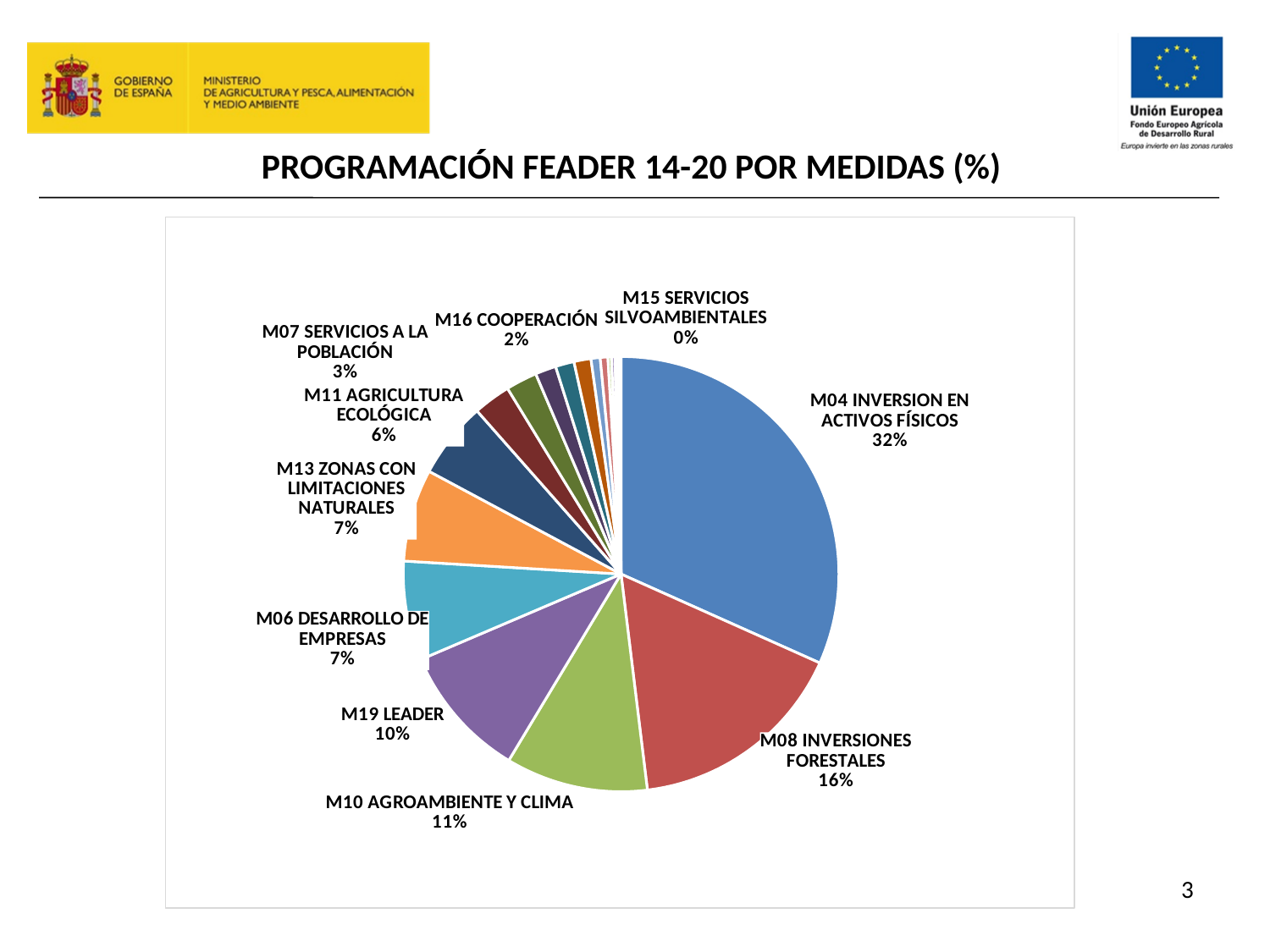
What percentage is shown for M19 LEADER? 10% What percentage is shown for M07 SERVICIOS A LA POBLACIÓN? 3% What percentage is shown for M11 AGRICULTURA ECOLÓGICA? 6% Which is larger, M10 AGROAMBIENTE Y CLIMA or M19 LEADER? M10 AGROAMBIENTE Y CLIMA What is the title of the chart? PROGRAMACIÓN FEADER 14-20 POR MEDIDAS (%) Which measure has the largest slice of the pie? M04 INVERSION EN ACTIVOS FÍSICOS What is the difference in percentage points between M04 INVERSION EN ACTIVOS FÍSICOS and M08 INVERSIONES FORESTALES? 16 What percentage is shown for M08 INVERSIONES FORESTALES? 16% What percentage is shown for M10 AGROAMBIENTE Y CLIMA? 11% What percentage is shown for M04 INVERSION EN ACTIVOS FÍSICOS? 32% What share of the pie does M16 COOPERACIÓN represent? 2% What kind of chart is shown on the slide? Pie chart